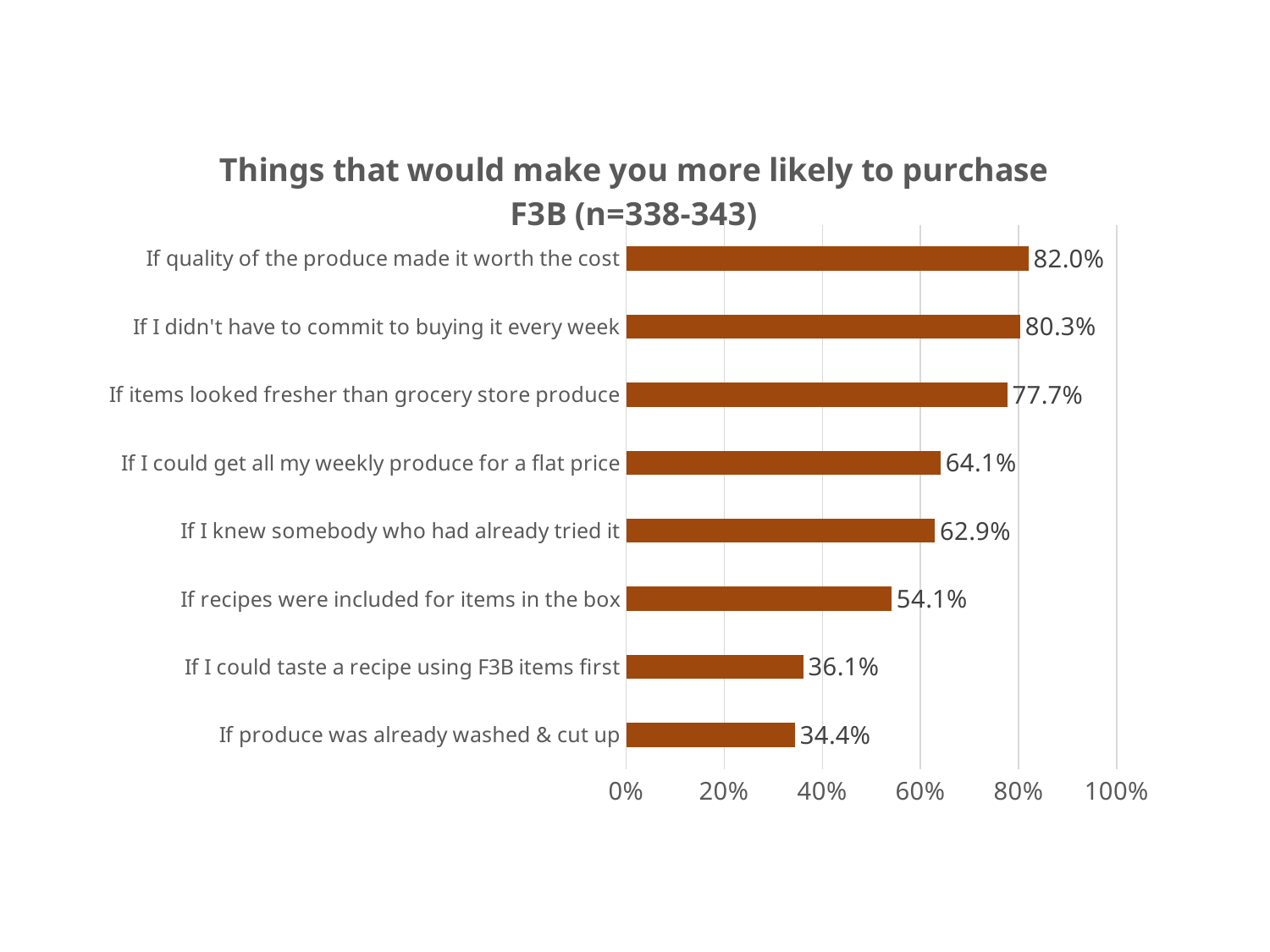
What is the value for "If produce was already washed & cut up"? 34.4% Which category has the highest value? If quality of the produce made it worth the cost Which category has the lowest value? If produce was already washed & cut up What is the title of the chart? Things that would make you more likely to purchase F3B (n=338-343) Which is larger: the value for "If I didn't have to commit to buying it every week" or "If items looked fresher than grocery store produce"? If I didn't have to commit to buying it every week How many categories are shown in the chart? 8 What percentage of respondents said they would be more likely to purchase F3B if the quality of the produce made it worth the cost? 82.0% What kind of chart is shown on the slide? Bar chart What is the value for "If recipes were included for items in the box"? 54.1% What is the difference between the highest and lowest values in the chart? 47.6% Is the value for "If I could taste a recipe using F3B items first" greater or less than 40%? less What is the difference between the values for "If I could get all my weekly produce for a flat price" and "If I knew somebody who had already tried it"? 1.2%